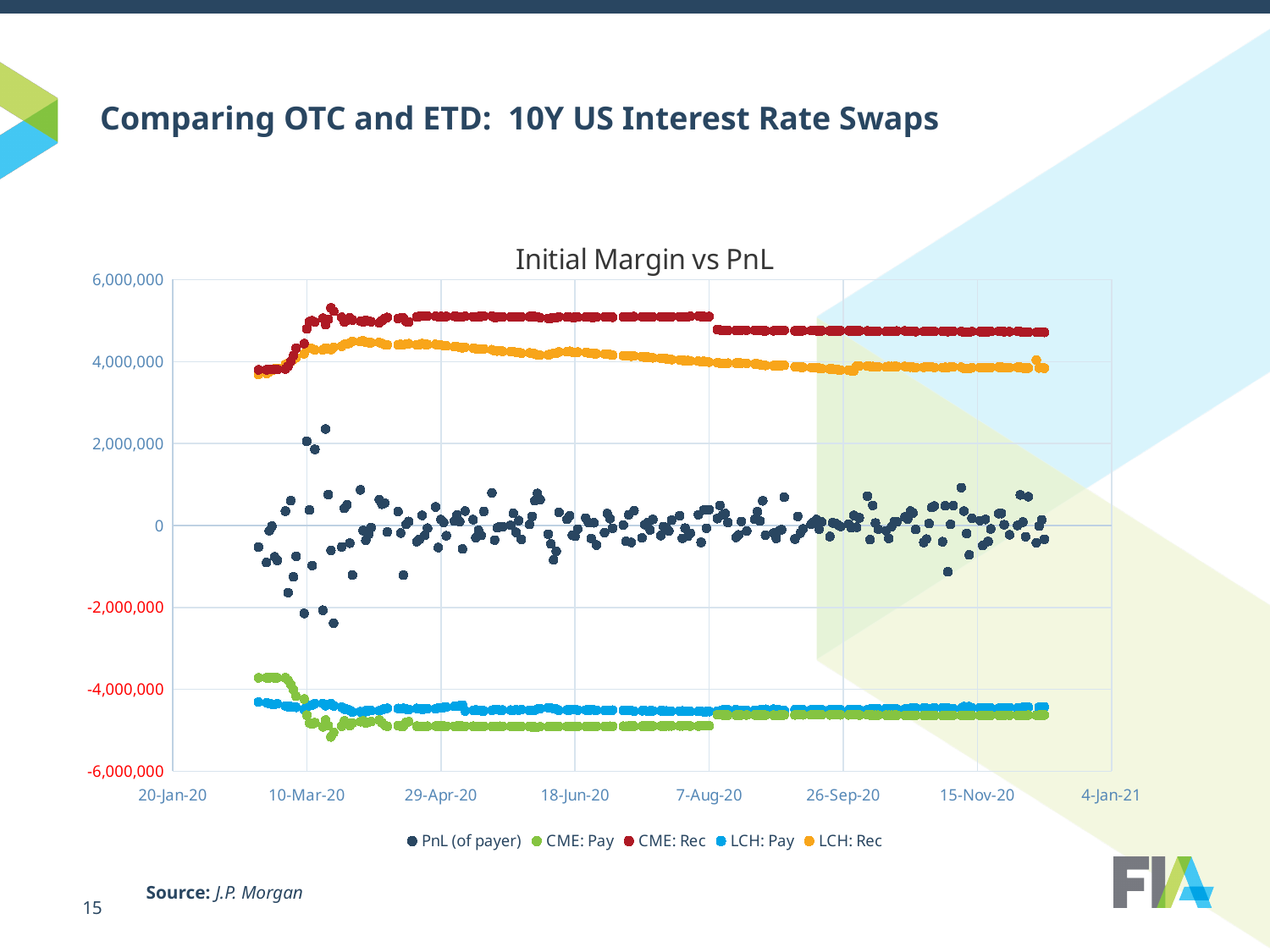
Is the value for CME: Rec around 15-Nov-20 greater or less than 4,000,000? greater Is the value for CME: Pay around 18-Jun-20 greater or less than -4,000,000? less What kind of chart is shown on the slide? Scatter chart Which colour represents the CME: Rec series in the chart? Red What is the title of the chart? Initial Margin vs PnL Is the value for LCH: Pay around 26-Sep-20 greater or less than -4,000,000? less How many series does the legend of the chart list? 5 Which series has the highest values in the chart? CME: Rec Which series has the lowest values in the chart? CME: Pay Which series is higher in the chart, CME: Rec or LCH: Rec? CME: Rec After its peak in spring 2020, does the LCH: Rec series rise or fall over the rest of the year? Fall Which series is lower in the chart, CME: Pay or LCH: Pay? CME: Pay